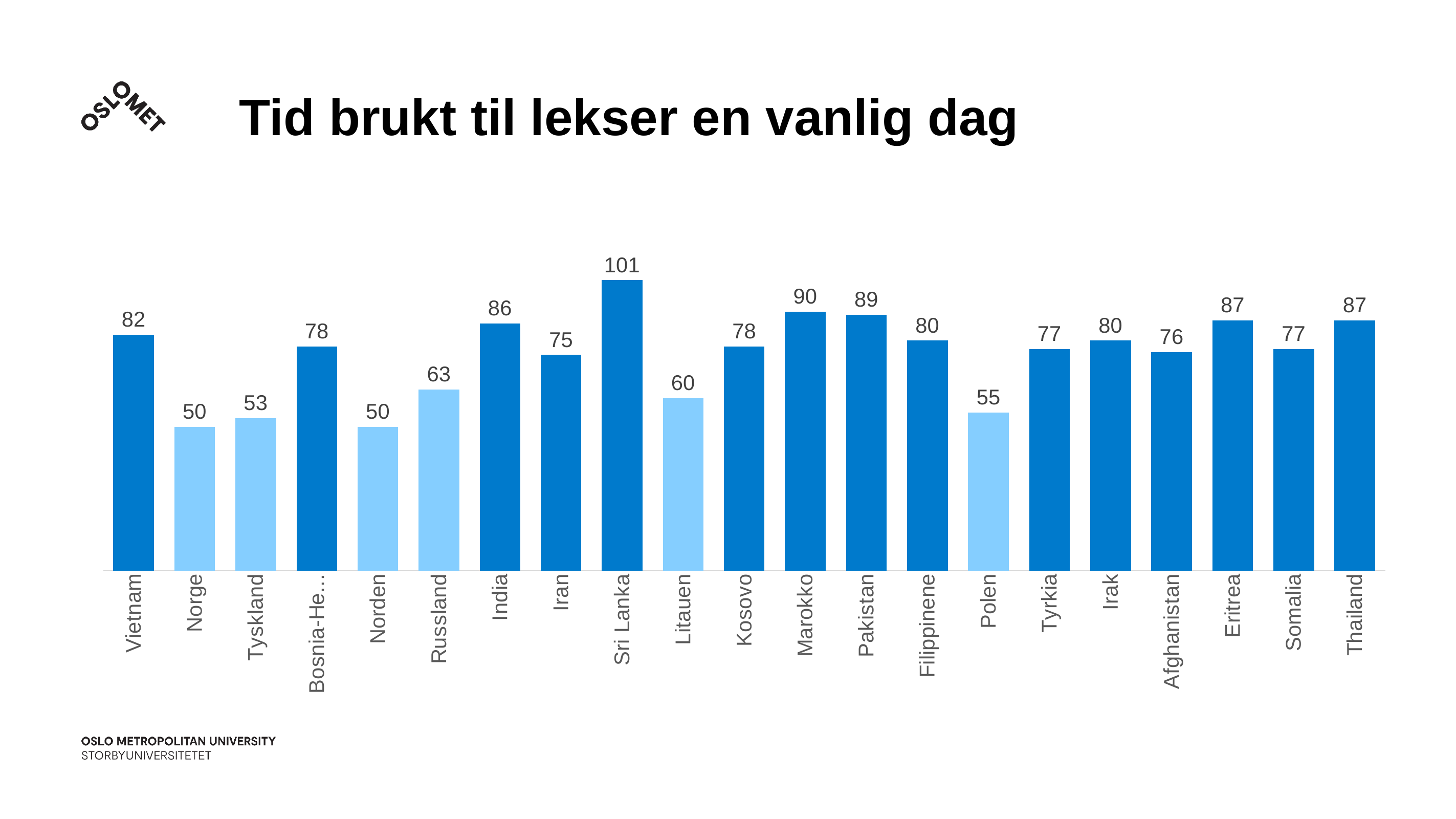
Which is larger, the value for Russland or the value for Litauen? Russland What is the difference between the values for Pakistan and Iran? 14 How many categories are shown in the chart? 21 What kind of chart is shown on the slide? Bar chart What is the value for Afghanistan? 76 What is the value for Polen? 55 Which is larger, the value for India or the value for Eritrea? Eritrea What is the value for Sri Lanka? 101 What is the value for Marokko? 90 Which category has the highest value? Sri Lanka What is the difference between the values for Sri Lanka and Norge? 51 What is the title of the slide? Tid brukt til lekser en vanlig dag